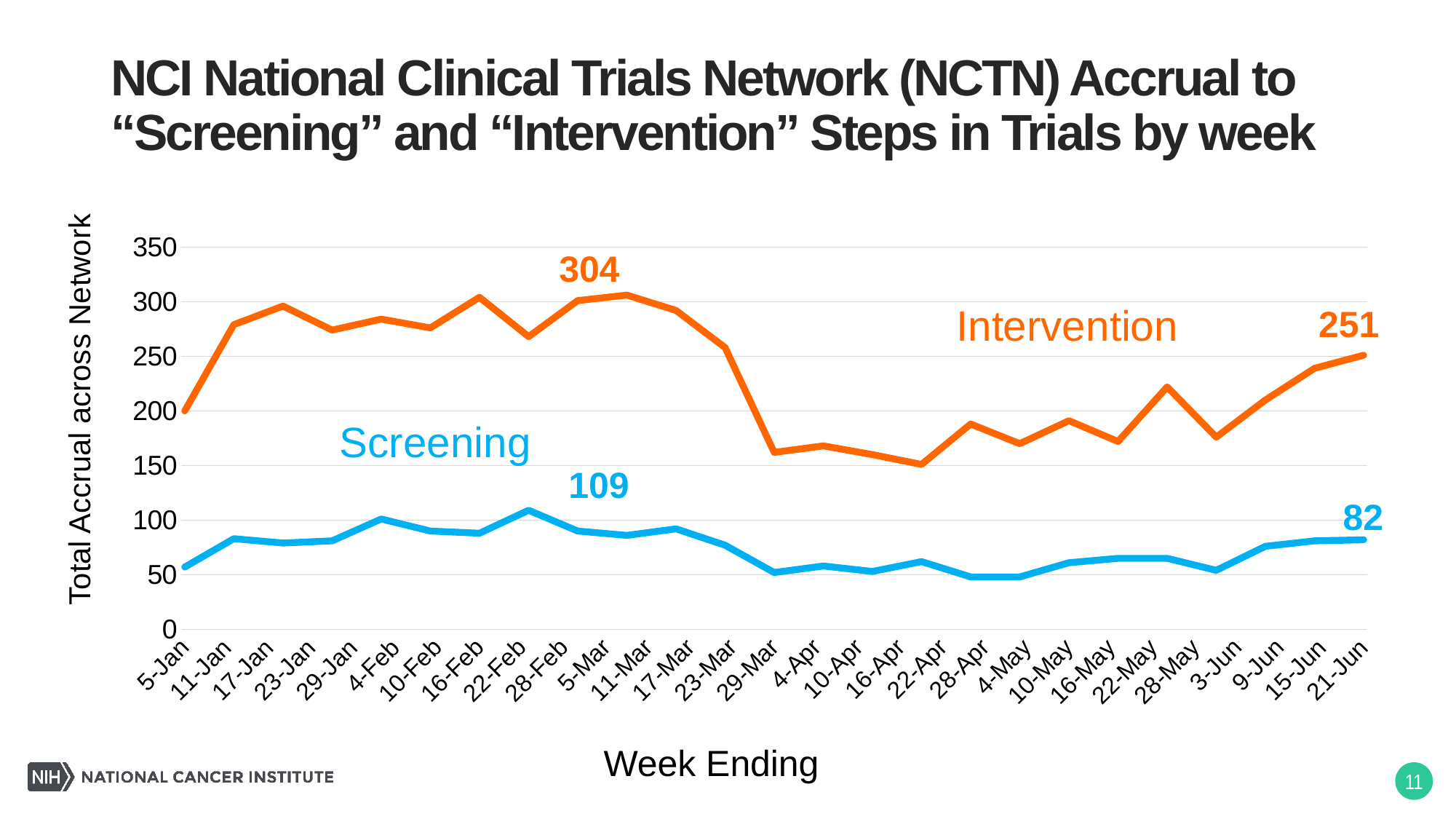
How many data series are plotted on the chart? 2 Which series has the higher value for the week ending 21-Jun, Intervention or Screening? Intervention What is the highest labelled value on the Intervention line? 304 What is the difference between the Intervention and Screening values for the week ending 21-Jun? 169 What is the title of the y axis? Total Accrual across Network Is the Intervention value for the week ending 29-Mar greater or less than 200? less What is the Intervention value for the week ending 21-Jun? 251 What is the Screening value for the week ending 21-Jun? 82 Does the Intervention line rise or fall between 17-Mar and 29-Mar? fall What is the highest labelled value on the Screening line? 109 What kind of chart is shown on the slide? line chart How many week-ending dates are shown on the x axis? 29